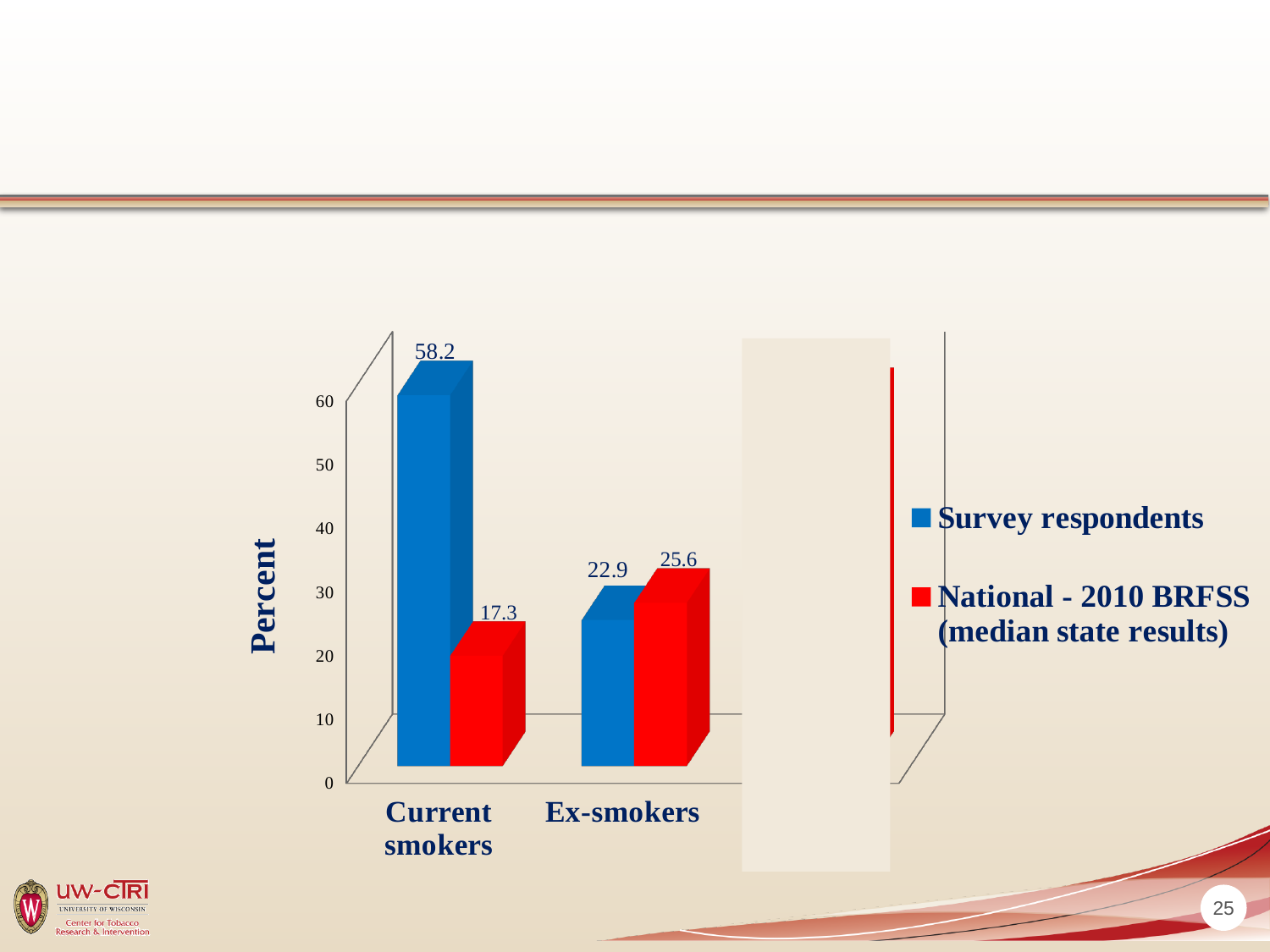
What is the label on the vertical axis of the chart? Percent What is the value for Survey respondents among Ex-smokers? 22.9 Which series has the higher value for Ex-smokers? National - 2010 BRFSS (median state results) Which series has the higher value for Current smokers? Survey respondents Is the Survey respondents value for Current smokers greater or less than 50? greater What kind of chart is shown on the slide? Bar chart What is the difference between the National - 2010 BRFSS and Survey respondents values for Ex-smokers? 2.7 What is the difference between the Survey respondents and National - 2010 BRFSS values for Current smokers? 40.9 What is the value for Survey respondents among Current smokers? 58.2 What is the value for National - 2010 BRFSS (median state results) among Ex-smokers? 25.6 How many series does the legend list? 2 What is the value for National - 2010 BRFSS (median state results) among Current smokers? 17.3